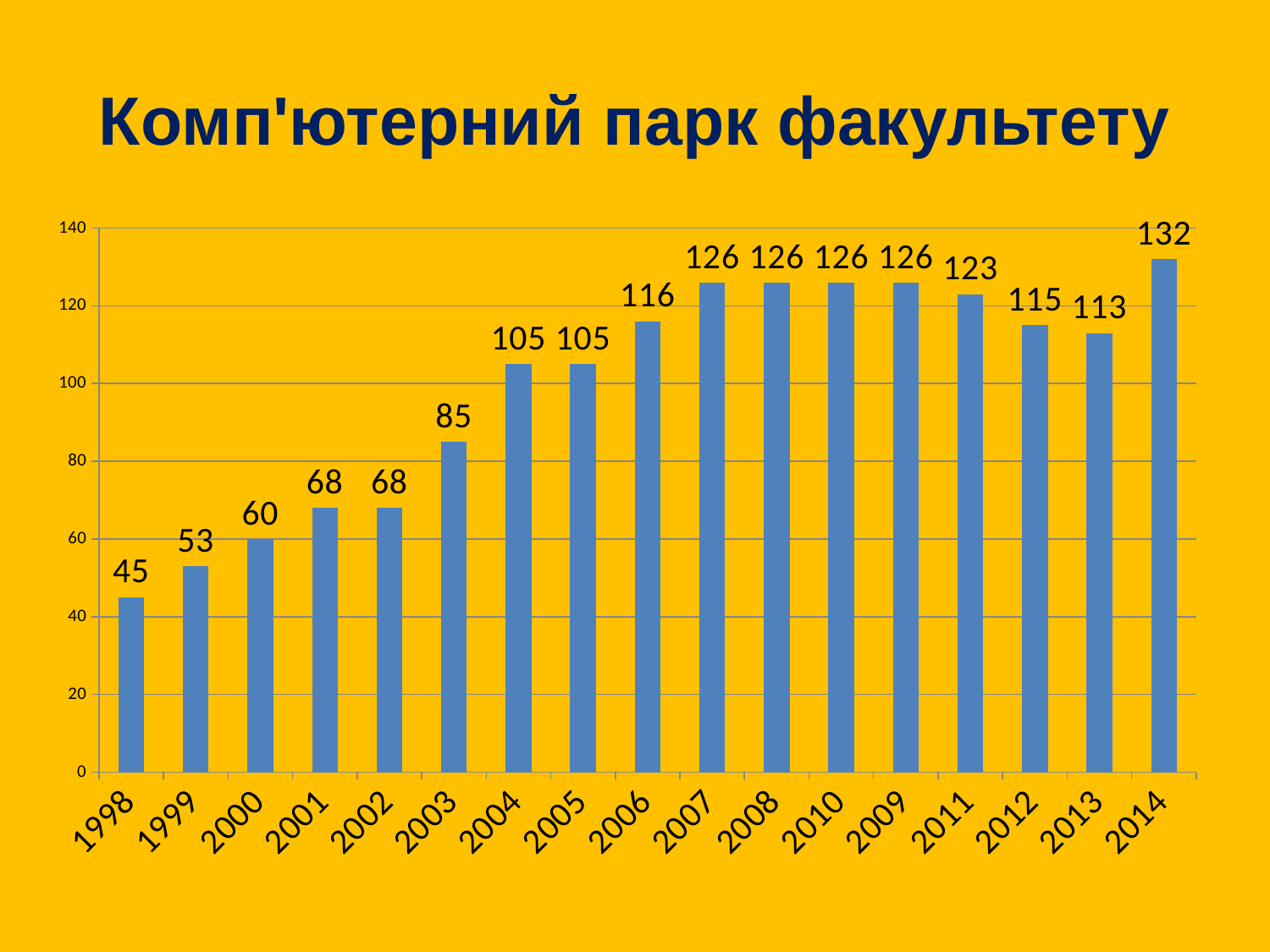
What is the difference between the values for 2014 and 1998? 87 What is the value for 1998? 45 Which is larger, the value for 2012 or the value for 2013? 2012 How many bars are shown in the chart? 17 What is the value for 2011? 123 What is the value for 2014? 132 Which year has the lowest value? 1998 What is the difference between the values for 2006 and 2005? 11 What kind of chart is shown on the slide? Bar chart What is the title of the chart on the slide? Комп'ютерний парк факультету What is the value for 2003? 85 Which year has the highest value? 2014